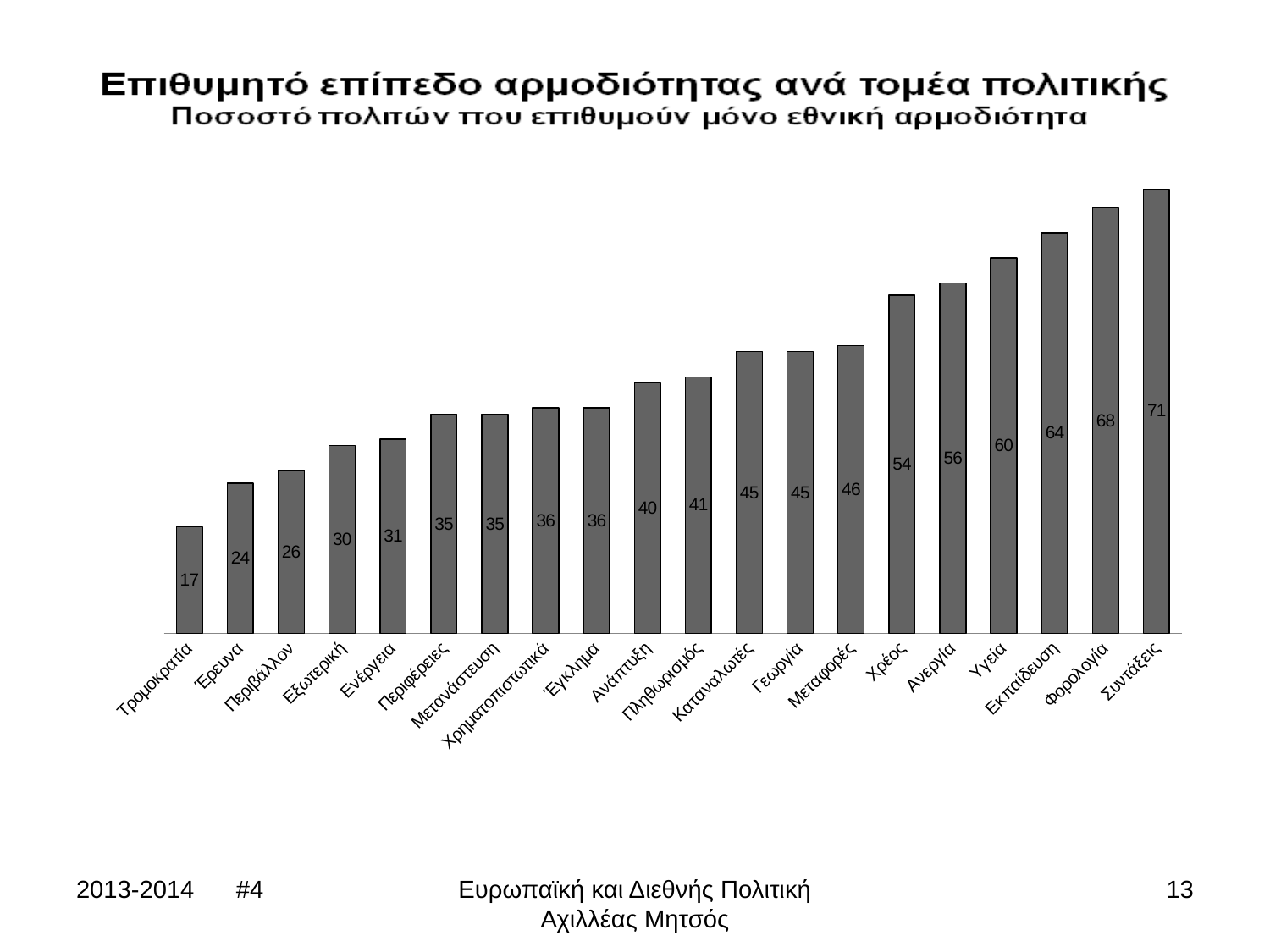
What is the difference between the values for Ανεργία and Έρευνα? 32 What is the difference between the values for Συντάξεις and Φορολογία? 3 Which category has the highest value? Συντάξεις How many categories are shown in the chart? 20 What is the value for Χρέος? 54 What is the value for Πληθωρισμός? 41 Which category has the lowest value? Τρομοκρατία What kind of chart is shown on the slide? Bar chart Which is larger, the value for Εκπαίδευση or the value for Μεταφορές? Εκπαίδευση Do the values rise or fall from left to right along the x axis? Rise What is the value for Τρομοκρατία? 17 What is the value for Υγεία? 60